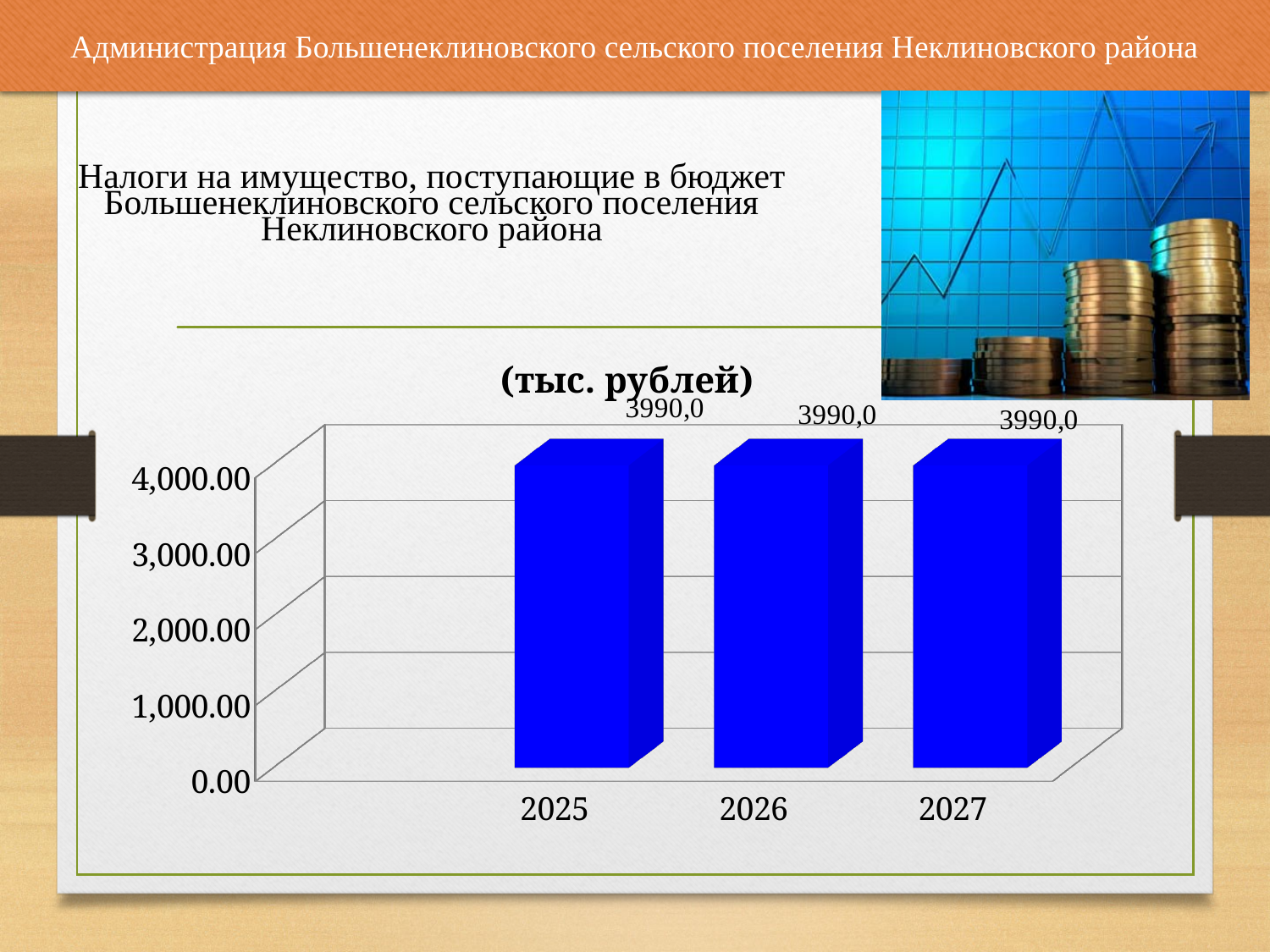
Is the value for 2025 greater or less than 4,000.00? less What colour are the bars in the chart? blue What kind of chart is shown on the slide? bar chart What is the difference between the values for 2025 and 2027? 0 What is the value for 2027? 3990,0 Do the values rise, fall or stay the same from 2025 to 2027? stay the same What is the value for 2026? 3990,0 Is the value for 2027 greater or less than 3,000.00? greater How many categories (years) are shown on the x axis? 3 Is the value for 2026 larger than, smaller than, or equal to the value for 2025? equal What is the title shown above the chart? (тыс. рублей) What is the value for 2025? 3990,0